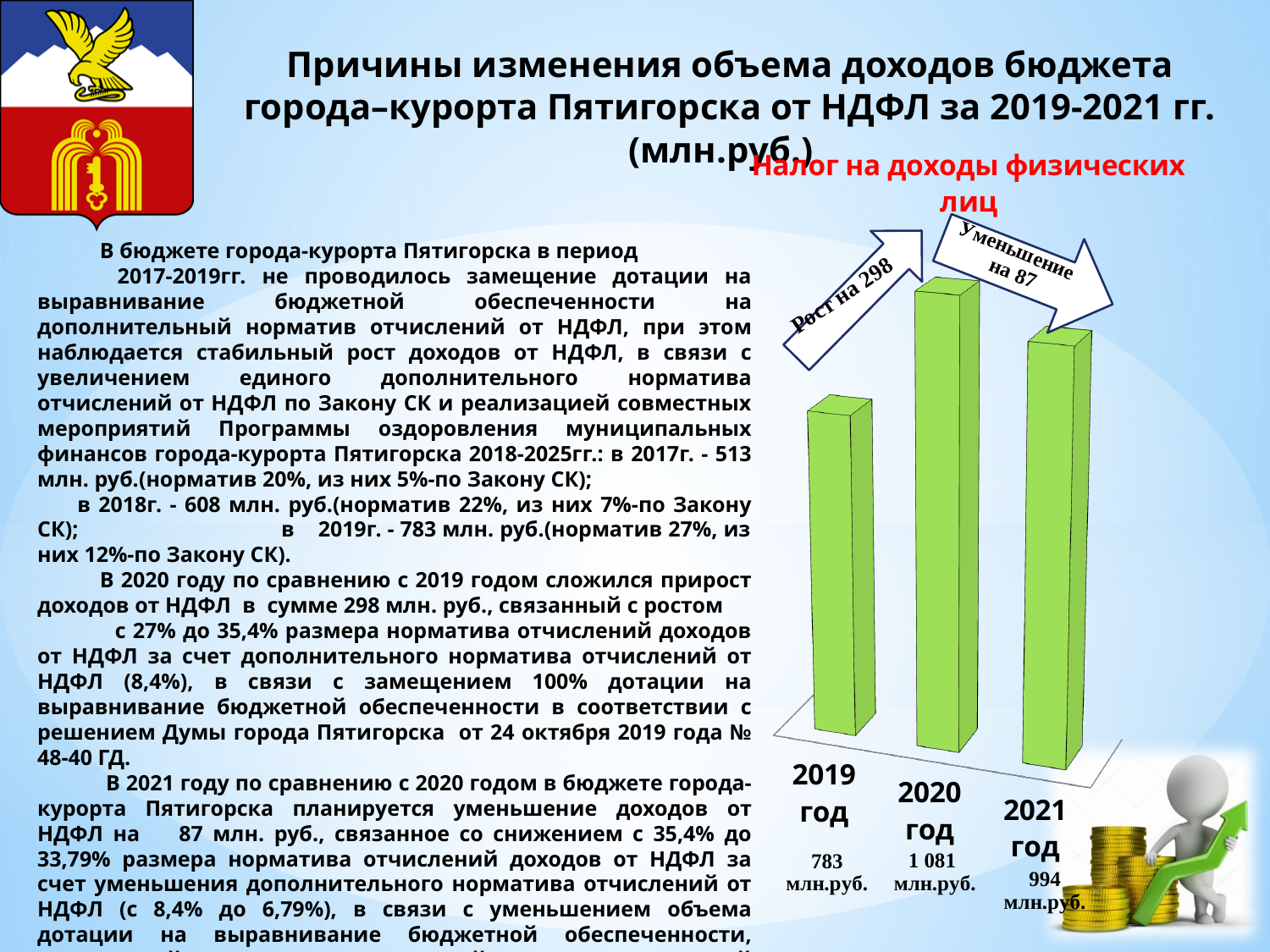
How many bars are shown on the chart? 3 What is the title of the chart? Налог на доходы физических лиц Which year has the highest value on the chart? 2020 год What kind of chart is shown on the slide? Bar chart What is the difference between the values for 2020 год and 2021 год? 87 млн.руб. What is the value for 2021 год on the chart? 994 млн.руб. What is the difference between the values for 2020 год and 2019 год? 298 млн.руб. What is the value for 2020 год on the chart? 1 081 млн.руб. Which year has the lowest value on the chart? 2019 год Does the value rise or fall from 2020 год to 2021 год? Fall Which is larger, the value for 2021 год or the value for 2019 год? 2021 год What is the value for 2019 год on the chart? 783 млн.руб.